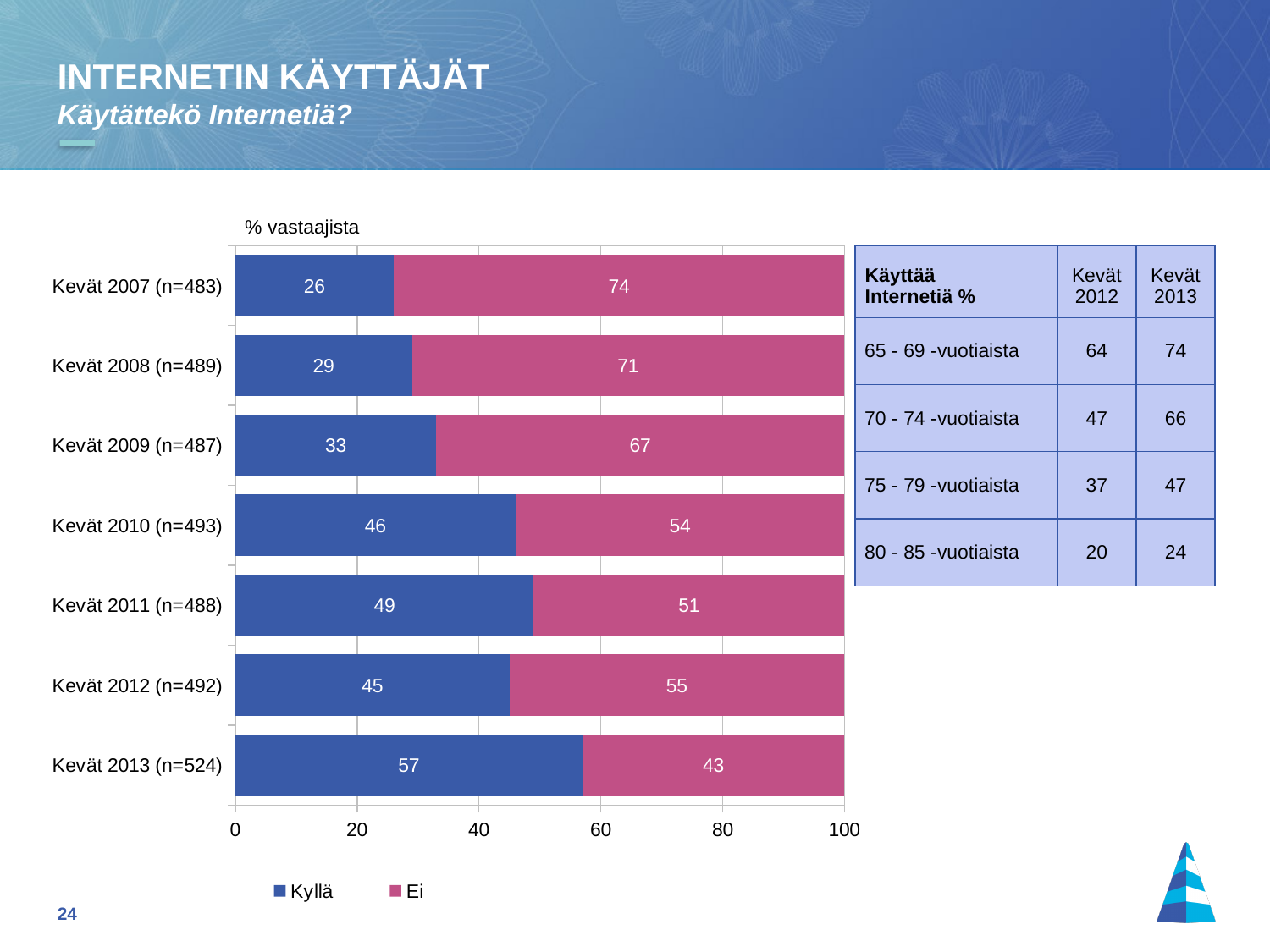
What are the two series listed in the legend? Kyllä and Ei What kind of chart is shown on the slide? Stacked bar chart What is the total of the stacked bar for Kevät 2009 (n=487)? 100 What is the Ei value for Kevät 2007 (n=483)? 74 What is the difference between the Kyllä values for Kevät 2013 (n=524) and Kevät 2007 (n=483)? 31 Which is larger, the Kyllä value for Kevät 2011 (n=488) or for Kevät 2012 (n=492)? Kevät 2011 (n=488) Which year has the highest Kyllä value? Kevät 2013 (n=524) What is the Kyllä value for Kevät 2013 (n=524)? 57 How many years (categories) are shown in the chart? 7 How many series does the legend list? 2 Which year has the lowest Kyllä value? Kevät 2007 (n=483) What is the Kyllä value for Kevät 2010 (n=493)? 46